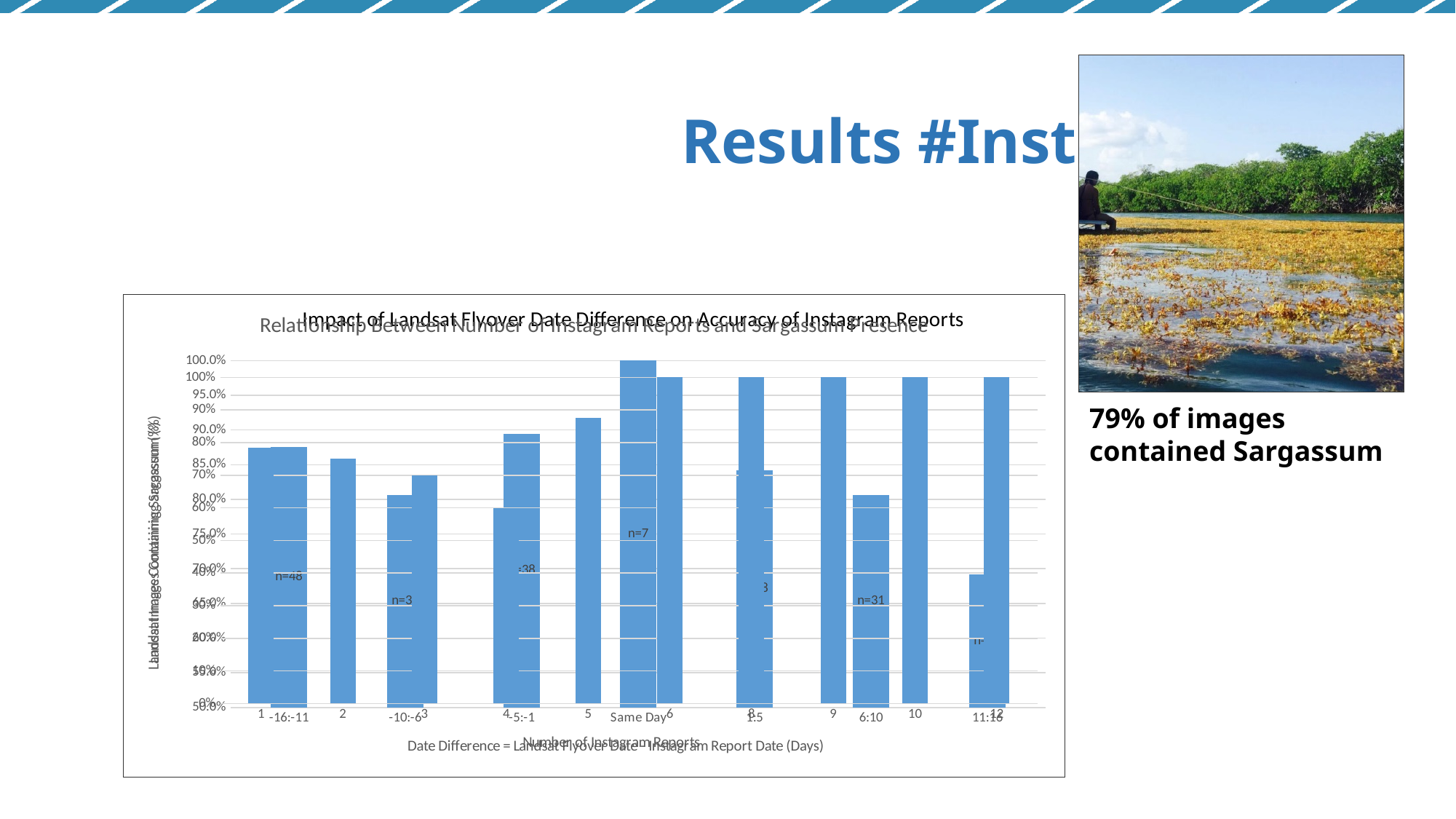
What kind of chart is shown on the slide? bar chart What is the title of the second chart overlaid on the slide, about the number of Instagram reports? Relationship Between Number of Instagram Reports and Sargassum Presence In the chart titled 'Impact of Landsat Flyover Date Difference on Accuracy of Instagram Reports', which date-difference category has the highest accuracy? Same Day In the chart titled 'Impact of Landsat Flyover Date Difference on Accuracy of Instagram Reports', what sample size label is printed on the 6:10 bar? n=31 In the chart titled 'Impact of Landsat Flyover Date Difference on Accuracy of Instagram Reports', what sample size label is printed on the -16:-11 bar? n=48 What is the x-axis label of the chart titled 'Relationship Between Number of Instagram Reports and Sargassum Presence'? Number of Instagram Reports In the chart titled 'Impact of Landsat Flyover Date Difference on Accuracy of Instagram Reports', what sample size label is printed on the Same Day bar? n=7 In the chart titled 'Impact of Landsat Flyover Date Difference on Accuracy of Instagram Reports', how many date-difference categories are shown on the x axis? 7